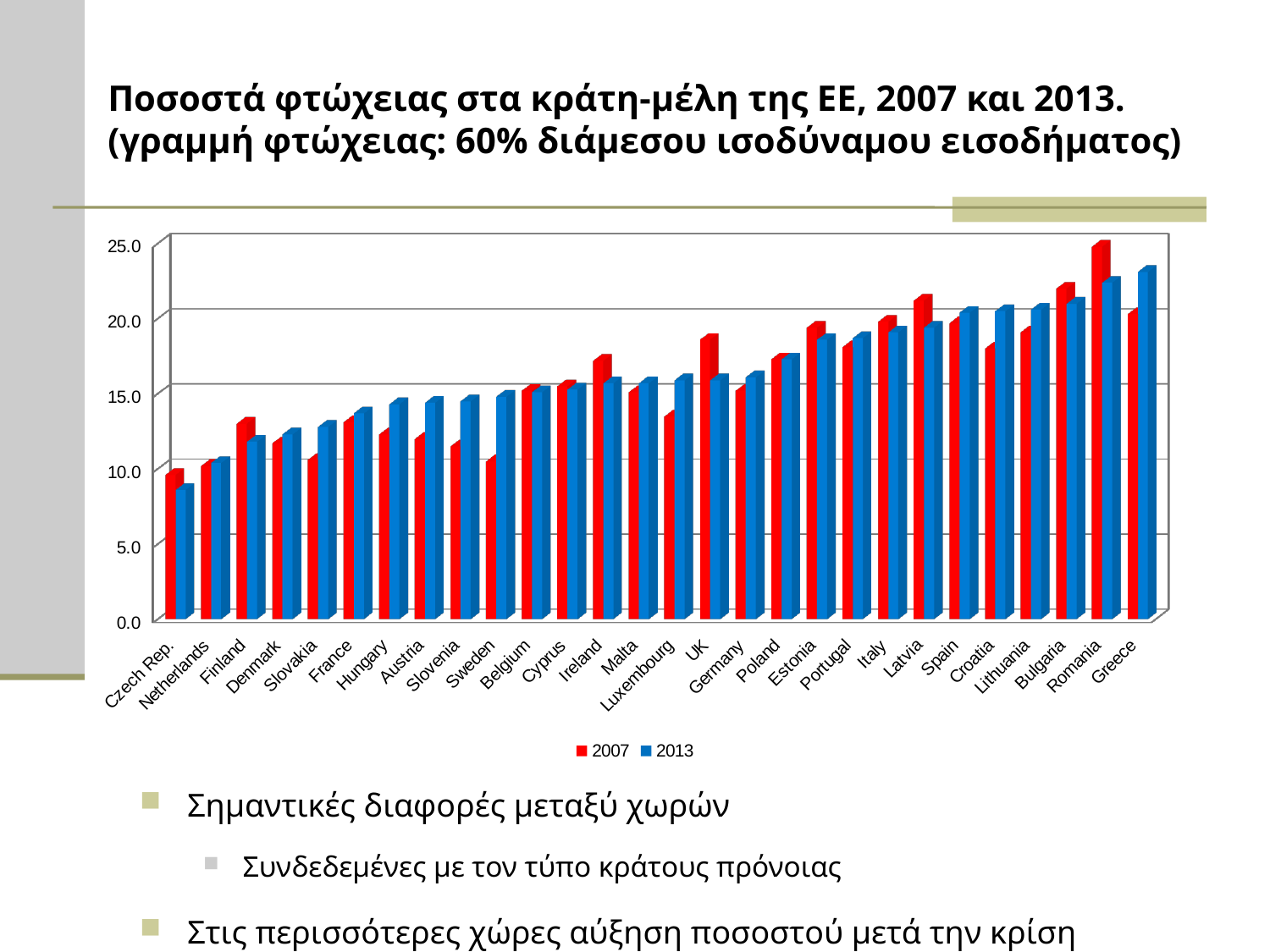
How many series does the legend list? 2 Is the value for Romania in 2007 greater or less than 20.0? greater Which country has the lowest value for 2013? Czech Rep. Is the value for Czech Rep. in 2013 greater or less than 10.0? less Which country has the highest value for 2007? Romania Which country has the highest value for 2013? Greece How many countries are shown on the x axis of the chart? 28 Is the value for Greece in 2013 greater or less than 20.0? greater What kind of chart is shown on the slide? bar chart Which colour represents the 2013 series in the legend? blue For Greece, which is larger: the 2007 value or the 2013 value? 2013 For Romania, which is larger: the 2007 value or the 2013 value? 2007